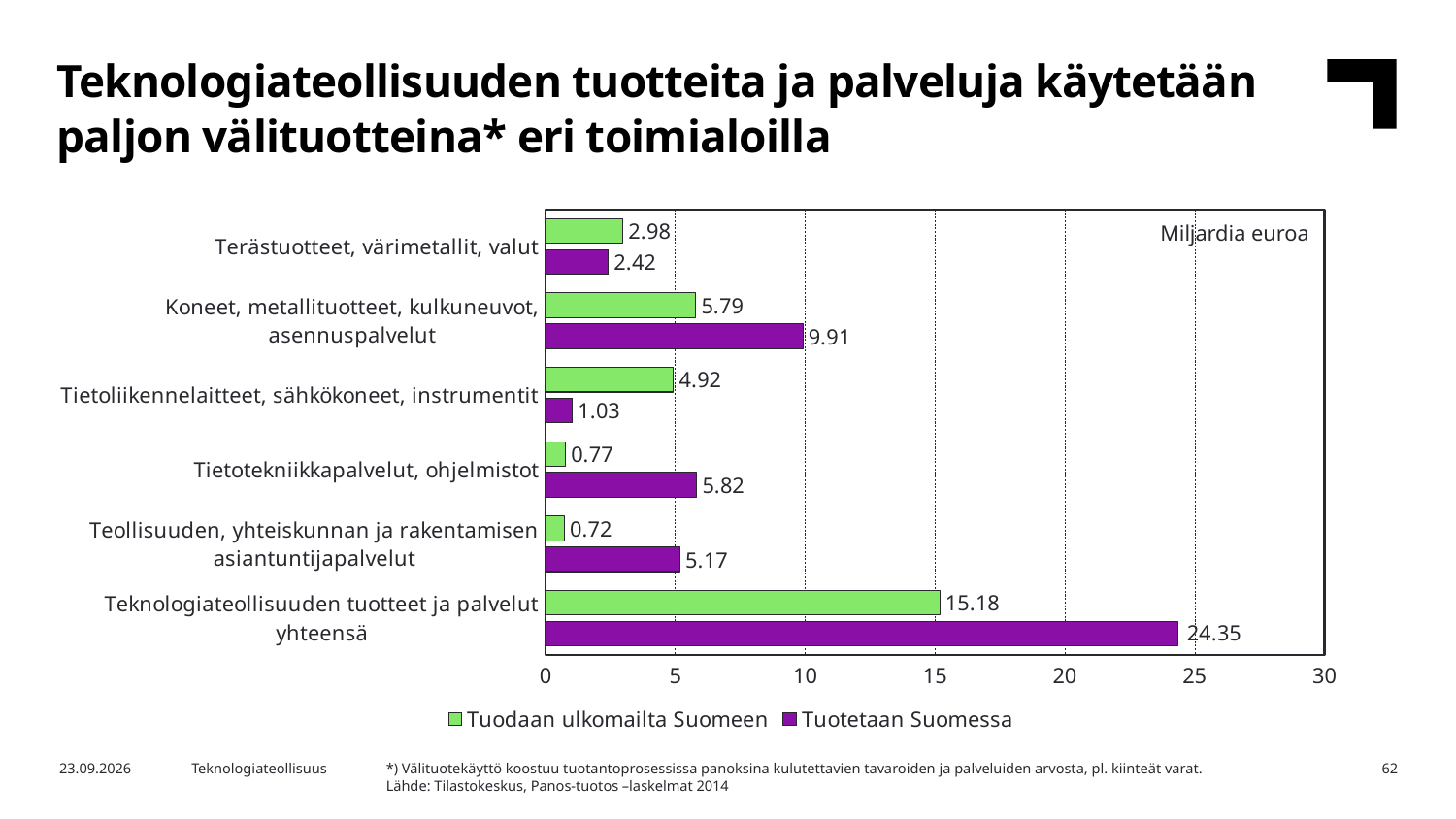
What is the difference between "Tuotetaan Suomessa" and "Tuodaan ulkomailta Suomeen" for "Teknologiateollisuuden tuotteet ja palvelut yhteensä"? 9.17 Which category has the lowest value for "Tuodaan ulkomailta Suomeen"? Teollisuuden, yhteiskunnan ja rakentamisen asiantuntijapalvelut For "Tietotekniikkapalvelut, ohjelmistot", which is larger: "Tuodaan ulkomailta Suomeen" or "Tuotetaan Suomessa"? Tuotetaan Suomessa How many categories are shown on the chart? 6 Which category has the highest value for "Tuotetaan Suomessa"? Teknologiateollisuuden tuotteet ja palvelut yhteensä What is the value of "Tuotetaan Suomessa" for "Teollisuuden, yhteiskunnan ja rakentamisen asiantuntijapalvelut"? 5.17 What unit is indicated in the top right corner of the chart? Miljardia euroa What kind of chart is shown on the slide? Bar chart How many series does the legend list? 2 Is the value of "Tuotetaan Suomessa" for "Teknologiateollisuuden tuotteet ja palvelut yhteensä" greater or less than 20? greater What is the value of "Tuotetaan Suomessa" for "Koneet, metallituotteet, kulkuneuvot, asennuspalvelut"? 9.91 What is the value of "Tuodaan ulkomailta Suomeen" for "Tietoliikennelaitteet, sähkökoneet, instrumentit"? 4.92